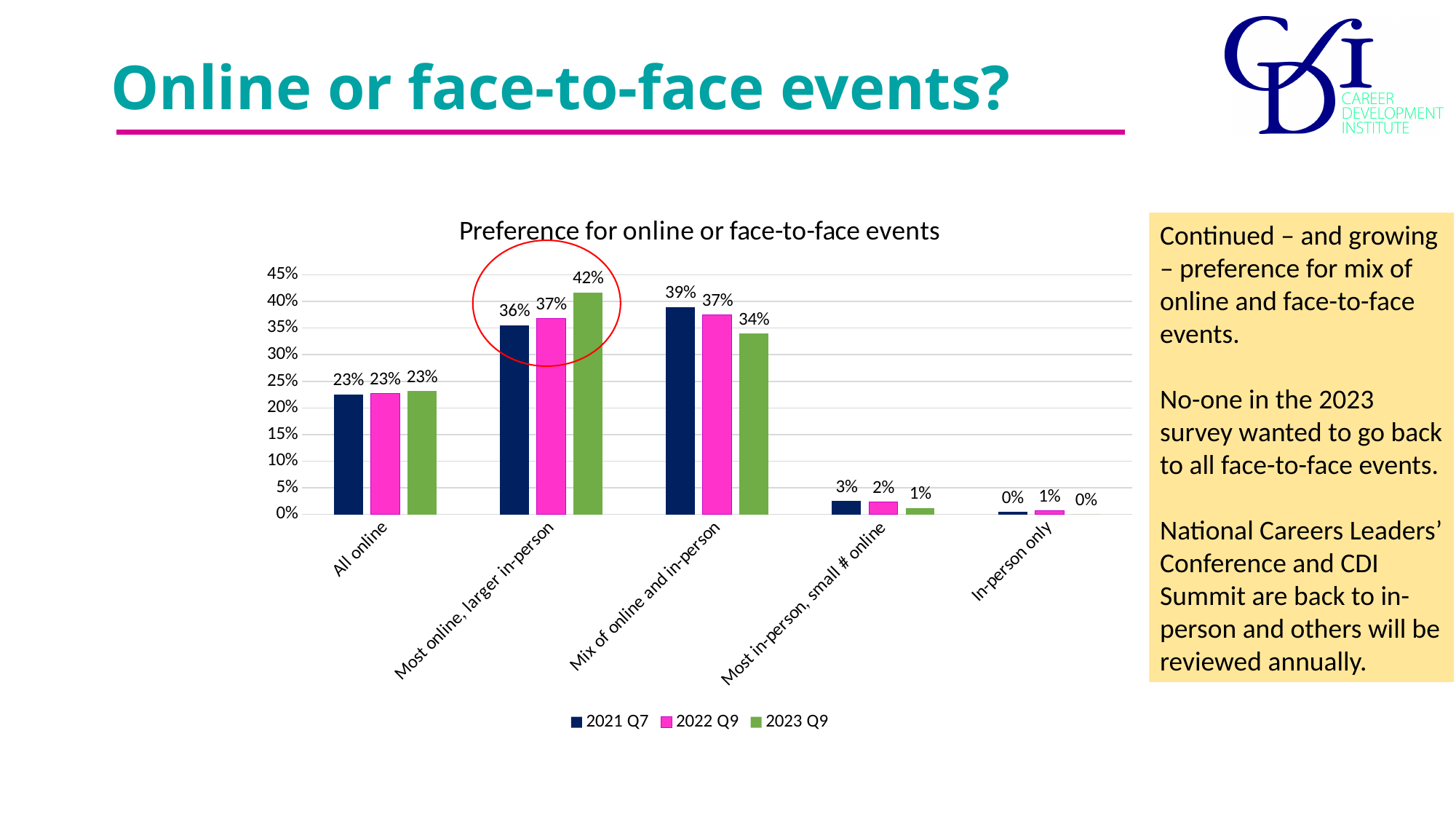
What kind of chart is shown on the slide? Bar chart How many series does the legend list? 3 How many categories are shown on the x axis? 5 Which category has the highest 2023 Q9 value? Most online, larger in-person What is the 2021 Q7 value for "Mix of online and in-person"? 39% What is the title of the chart? Preference for online or face-to-face events What is the 2023 Q9 value for "Most online, larger in-person"? 42% What is the 2022 Q9 value for "Most in-person, small # online"? 2% Which category has the lowest 2022 Q9 value? In-person only Across the three series, do the values for "Mix of online and in-person" rise or fall from 2021 Q7 to 2023 Q9? Fall For "Mix of online and in-person", which series has the larger value: 2021 Q7 or 2023 Q9? 2021 Q7 What is the difference between the 2023 Q9 and 2021 Q7 values for "Most online, larger in-person"? 6%